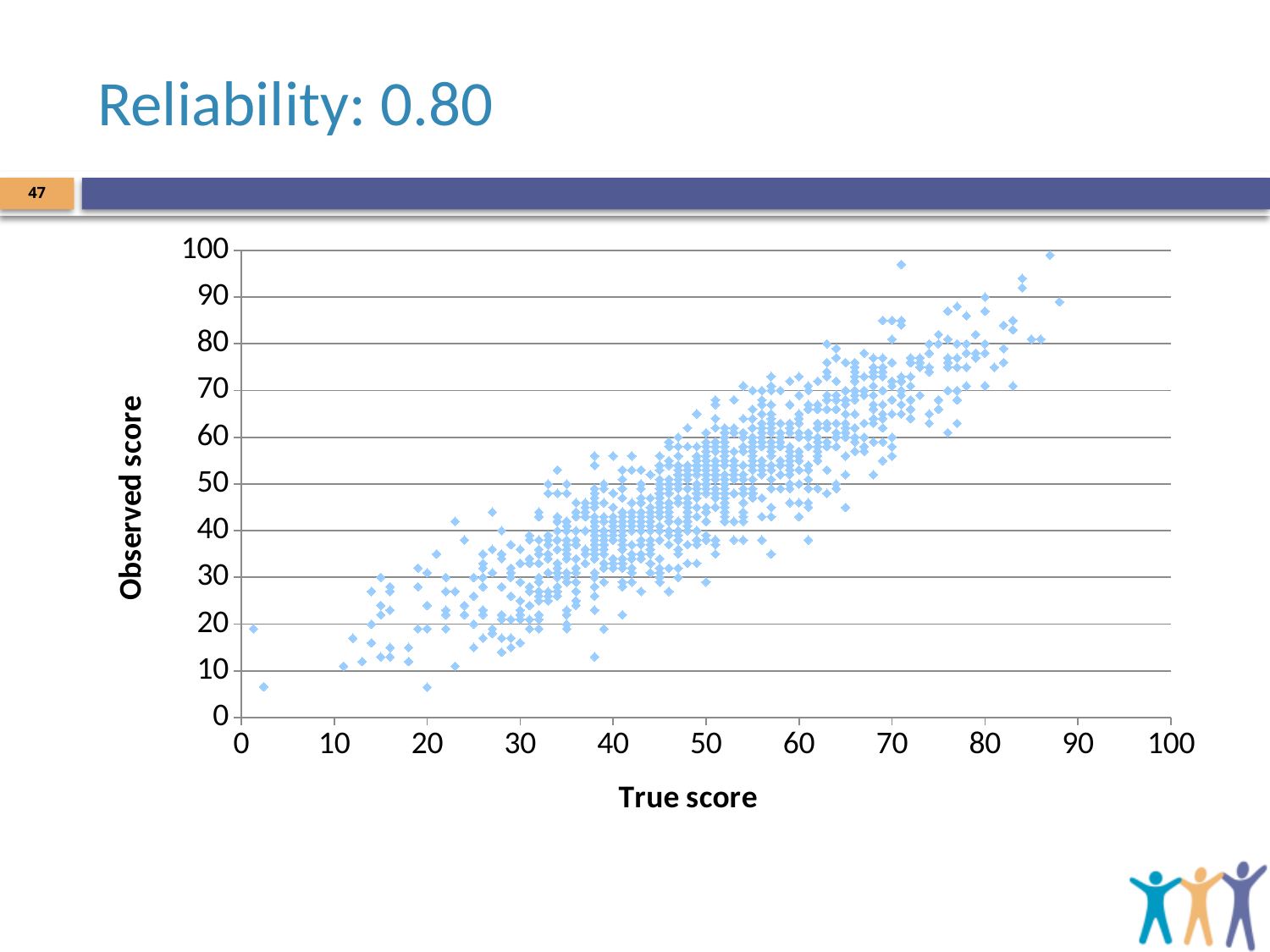
Are the observed scores for points with a true score near 20 mostly greater or less than 40? less What kind of chart is shown on the slide? Scatter plot What is the title of the y axis? Observed score Is the highest observed score plotted greater or less than 90? greater As the true score increases along the x axis, do the observed scores generally rise or fall? Rise Is the observed score of the point with the highest true score greater or less than 80? greater What is the title of the x axis? True score